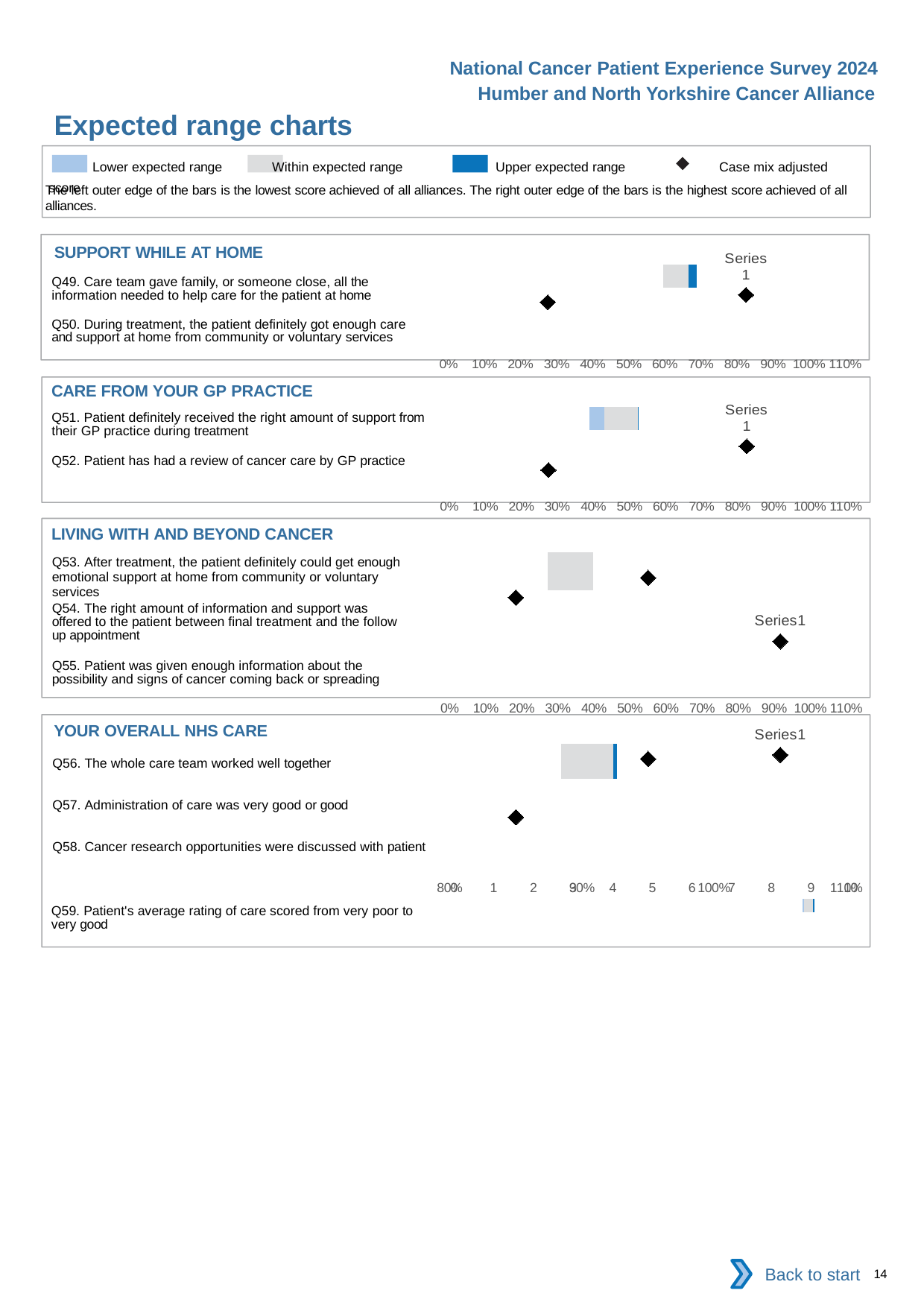
What kind of chart is used in the SUPPORT WHILE AT HOME section? bar chart How many entries does the legend at the top of the slide list? 4 How many questions are listed in the SUPPORT WHILE AT HOME chart? 2 How many questions are listed in the CARE FROM YOUR GP PRACTICE chart? 2 In the legend, what does the black diamond marker represent? Case mix adjusted score How many questions are listed in the LIVING WITH AND BEYOND CANCER chart? 3 In the YOUR OVERALL NHS CARE chart, is the case mix adjusted score marker for Q57 greater or less than 30%? less In the CARE FROM YOUR GP PRACTICE chart, is the case mix adjusted score marker for Q52 greater or less than 40%? less What is the highest percentage tick shown on the x axis of the SUPPORT WHILE AT HOME chart? 110% What is the title of the slide containing the charts? Expected range charts